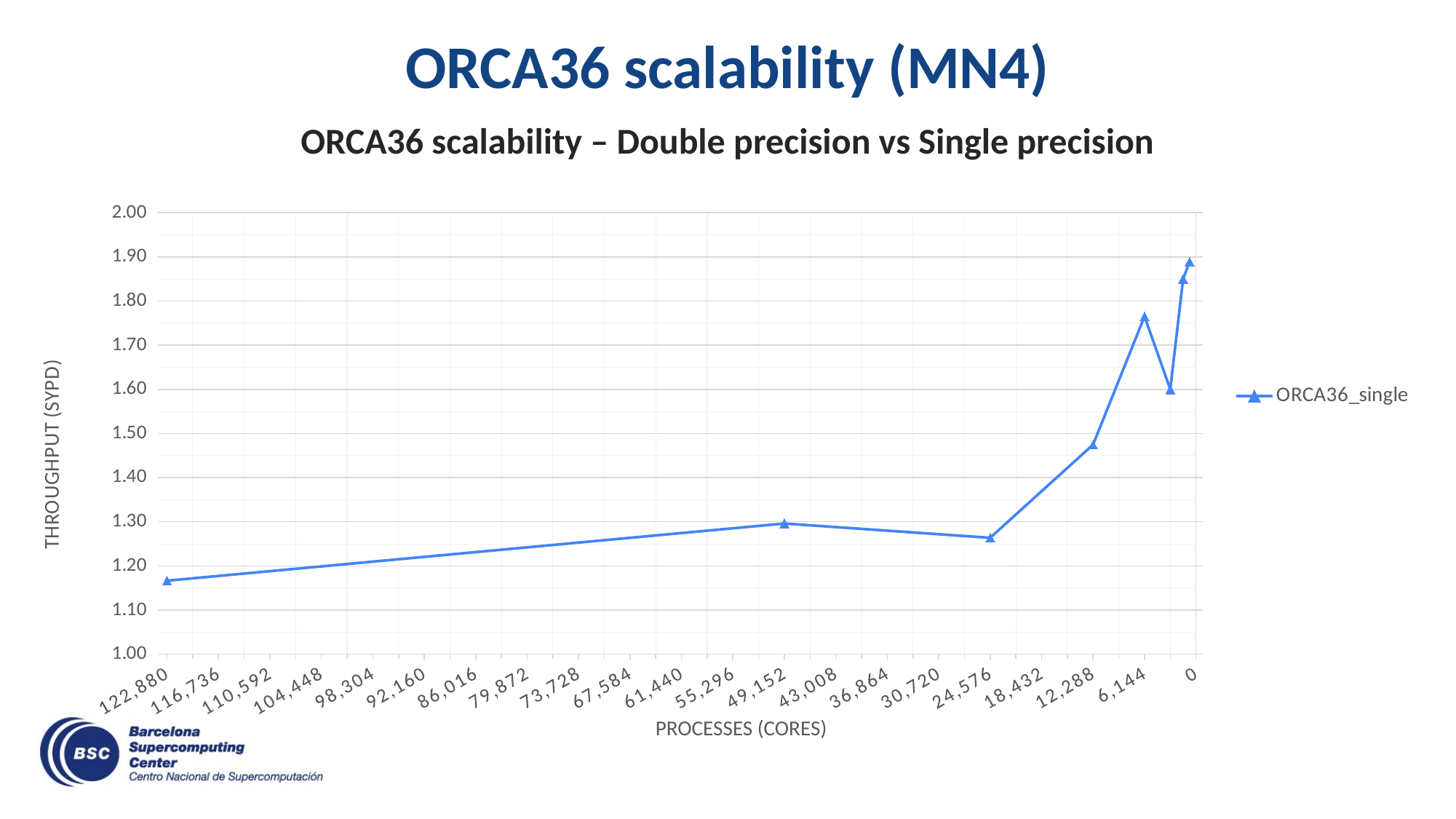
Is the throughput value at 12,288 processes greater or less than 1.40? greater How many series does the legend list? 1 What is the name of the series shown in the legend? ORCA36_single Which labelled x-axis category has the lowest throughput? 122,880 How many data points are plotted on the ORCA36_single line? 8 Moving from left to right along the x axis, does the throughput generally rise or fall? rise Is the throughput value at 6,144 processes greater or less than 1.70? greater Is the throughput value at 122,880 processes greater or less than 1.20? less Which has the higher throughput: 49,152 processes or 24,576 processes? 49,152 What kind of chart is shown on the slide? line chart What is the label of the y axis? THROUGHPUT (SYPD)